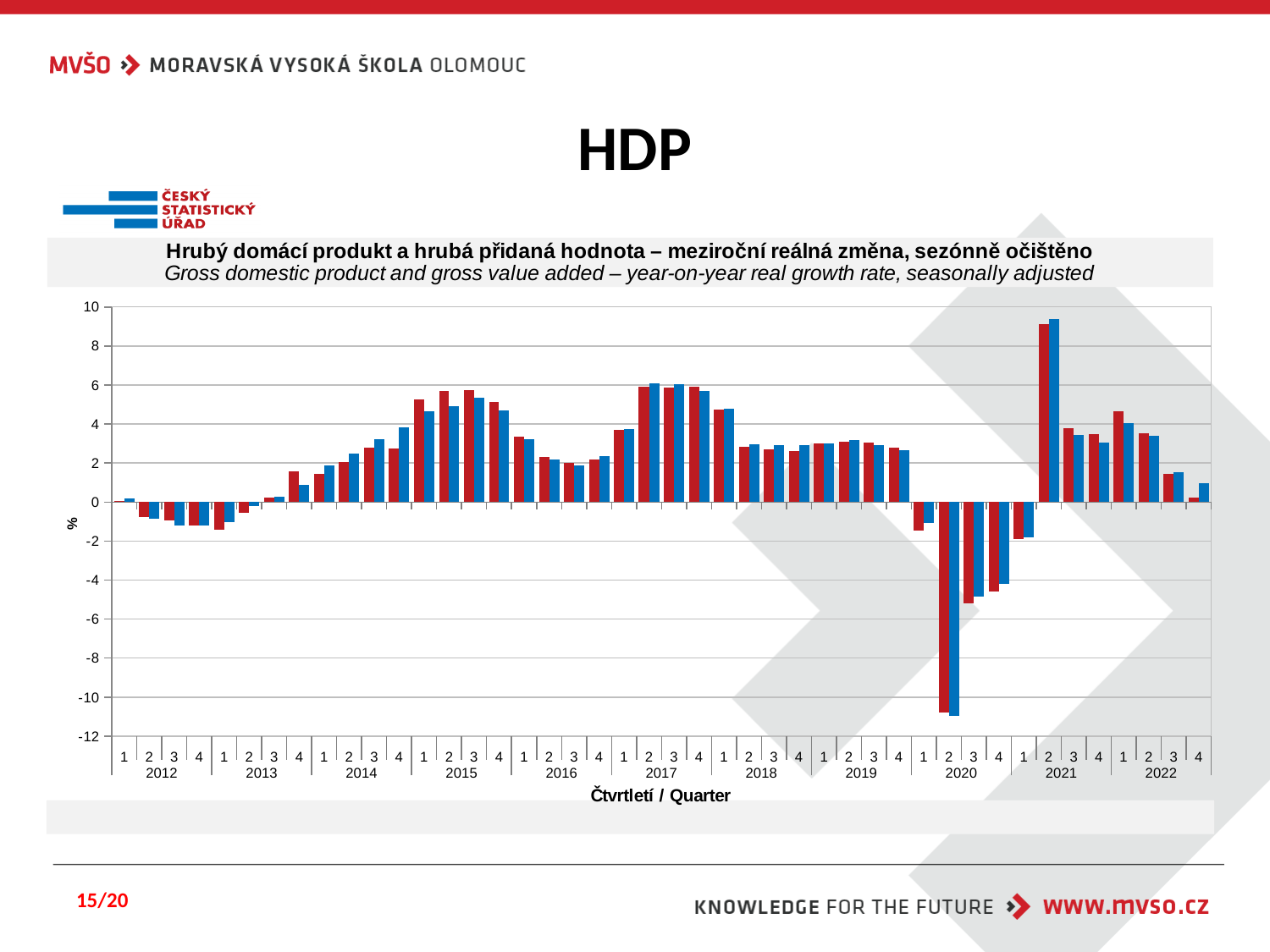
Is the value for quarter 2 of 2021 greater or less than 8? greater Is the value for quarter 3 of 2015 greater or less than 4? greater In which quarter and year do the bars reach their lowest value? Quarter 2 of 2020 Is the value for quarter 2 of 2020 greater or less than -10? less Do the values generally rise or fall from quarter 2 of 2017 to quarter 2 of 2020? fall Which is larger, the value for quarter 2 of 2017 or the value for quarter 2 of 2018? quarter 2 of 2017 What kind of chart is shown on the slide? bar chart What is the label of the y axis of the chart? % How many years are shown along the x axis of the chart? 11 What is the label of the x axis of the chart? Čtvrtletí / Quarter In which quarter and year do the bars reach their highest value? Quarter 2 of 2021